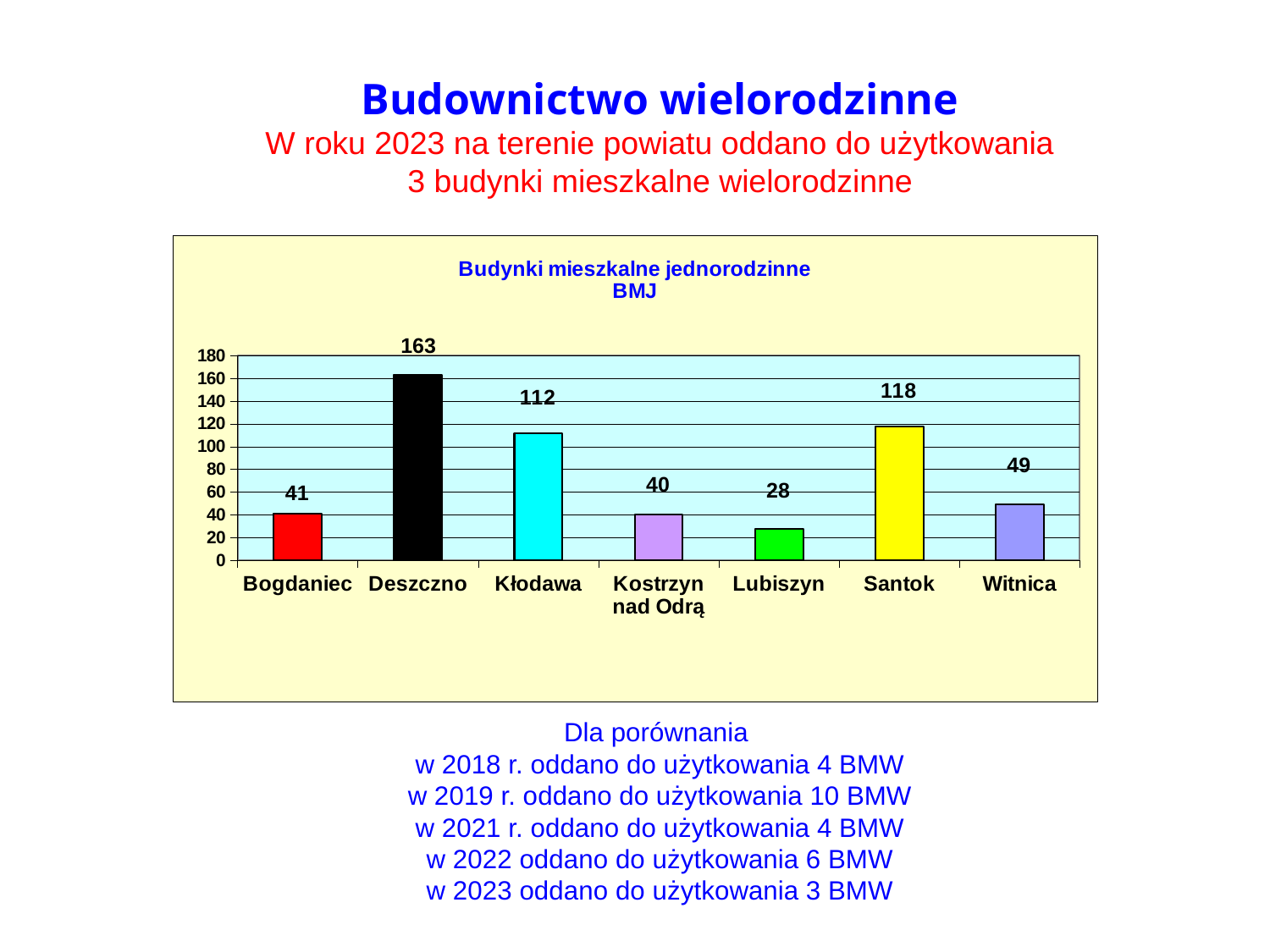
How many categories are shown on the x axis? 7 What is the value for Kostrzyn nad Odrą? 40 Which is larger, the value for Kłodawa or the value for Santok? Santok What is the value for Witnica? 49 Which category has the lowest value? Lubiszyn What is the difference between the values for Deszczno and Santok? 45 Is the value for Kłodawa greater or less than 100? greater What is the difference between the values for Bogdaniec and Lubiszyn? 13 What is the title of the chart? Budynki mieszkalne jednorodzinne BMJ Which category has the highest value? Deszczno What kind of chart is shown on the slide? bar chart What is the value for Deszczno? 163